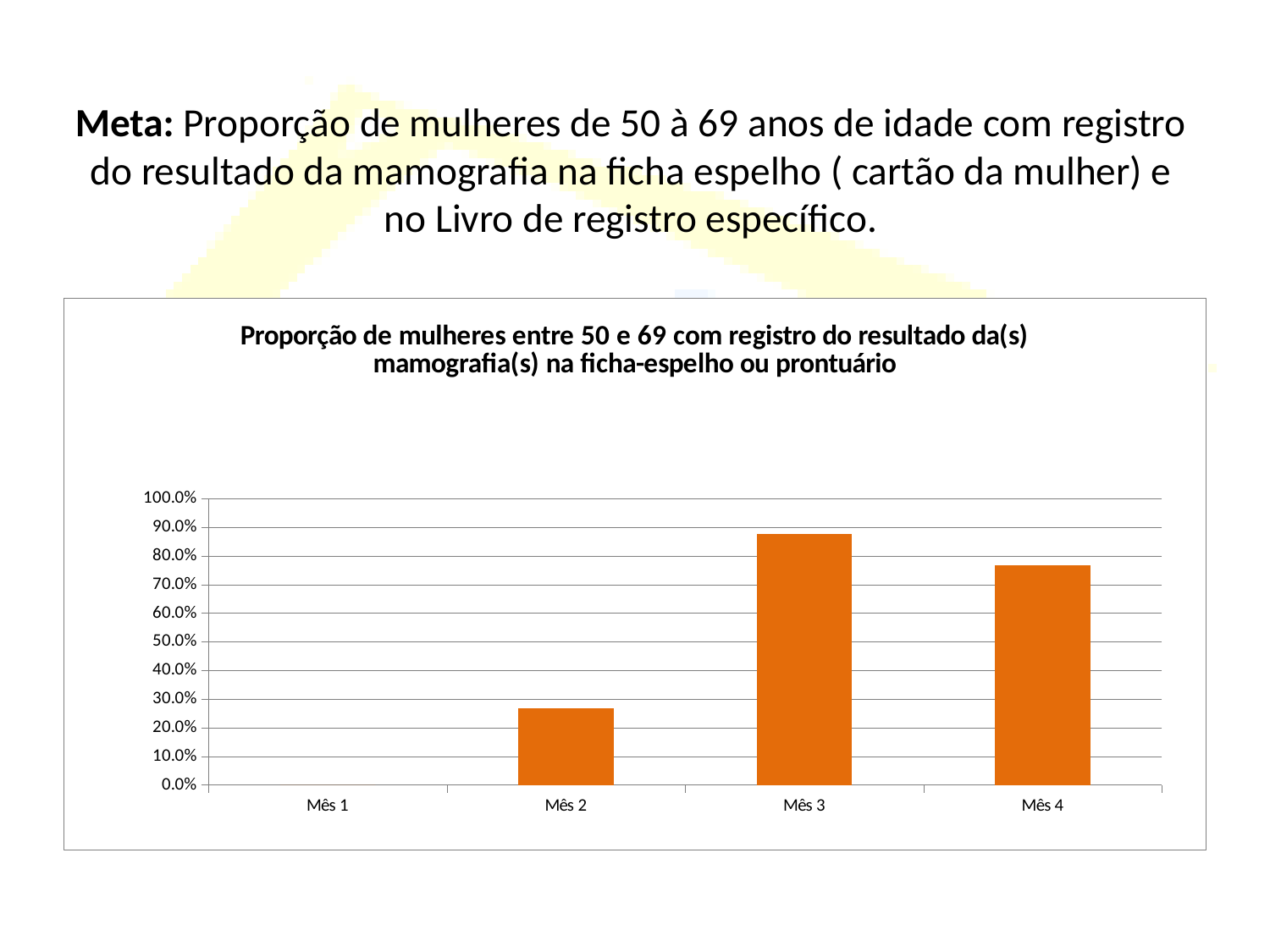
Is the value for Mês 4 greater or less than 70.0%? greater What kind of chart is shown on the slide? bar chart Is the value for Mês 3 greater or less than 90.0%? less Which month has the lowest value in the chart? Mês 1 Does the value rise or fall from Mês 2 to Mês 3? rise Which month has the highest value in the chart? Mês 3 Which is larger, the value for Mês 2 or the value for Mês 4? Mês 4 What is the title of the chart? Proporção de mulheres entre 50 e 69 com registro do resultado da(s) mamografia(s) na ficha-espelho ou prontuário Is the value for Mês 2 greater or less than 30.0%? less Which is larger, the value for Mês 3 or the value for Mês 4? Mês 3 How many categories (months) are shown on the x axis of the chart? 4